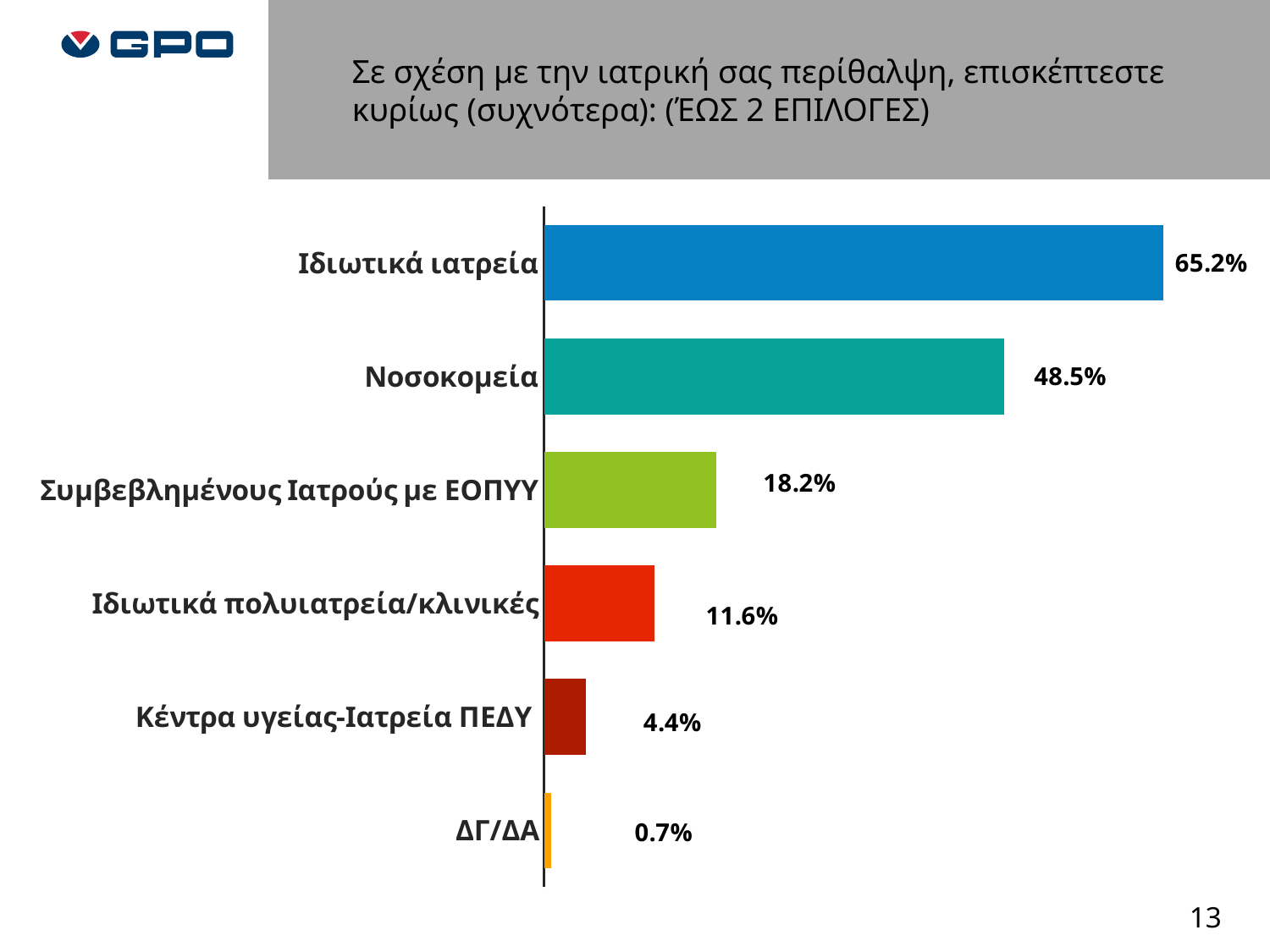
How many categories are shown in the chart? 6 Which is larger, the value for Συμβεβλημένους Ιατρούς με ΕΟΠΥΥ or the value for Ιδιωτικά πολυιατρεία/κλινικές? Συμβεβλημένους Ιατρούς με ΕΟΠΥΥ Which category has the highest value? Ιδιωτικά ιατρεία What is the value for Συμβεβλημένους Ιατρούς με ΕΟΠΥΥ? 18.2% What is the value for Ιδιωτικά ιατρεία? 65.2% Which category has the lowest value? ΔΓ/ΔΑ What colour is the bar for Νοσοκομεία? Teal What kind of chart is shown on the slide? Bar chart What is the difference between the values for Ιδιωτικά ιατρεία and Νοσοκομεία? 16.7% What is the value for Νοσοκομεία? 48.5% What is the difference between the values for Ιδιωτικά πολυιατρεία/κλινικές and Κέντρα υγείας-Ιατρεία ΠΕΔΥ? 7.2% What is the value for Κέντρα υγείας-Ιατρεία ΠΕΔΥ? 4.4%